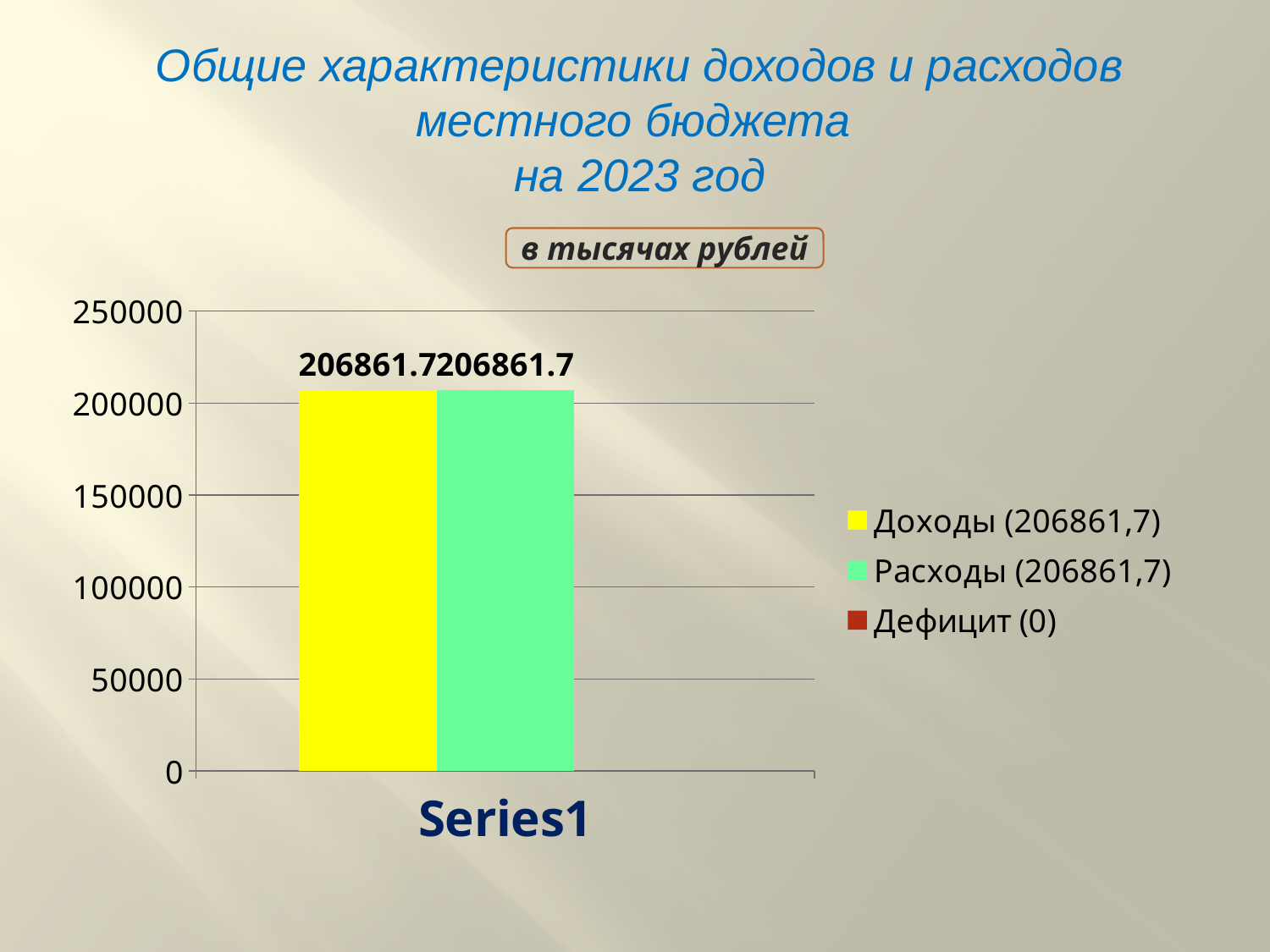
What is the value of the Расходы bar? 206861.7 Is the value for Расходы greater or less than 250000? less What is the category label shown on the x axis? Series1 What is the difference between the Доходы and Расходы values? 0 What is the highest value shown on the y axis? 250000 What value does the legend give for Дефицит? 0 What unit is stated above the chart? в тысячах рублей What type of chart is shown on the slide? bar chart What is the value of the Доходы bar? 206861.7 How many series does the legend list? 3 Which series has the lowest value according to the legend? Дефицит Is the value for Доходы greater or less than 200000? greater